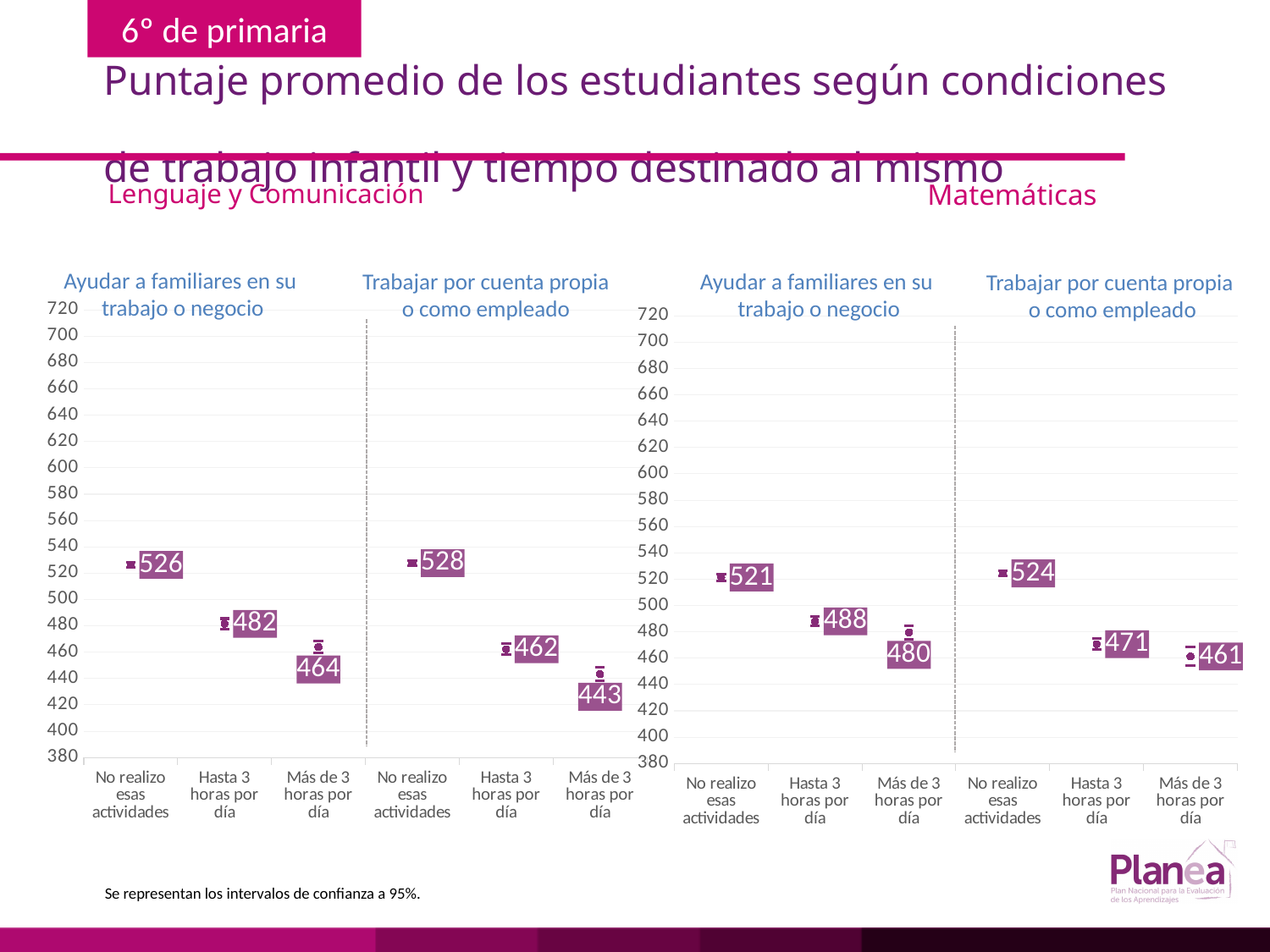
In the Matemáticas chart, what is the difference between the scores for No realizo esas actividades and Más de 3 horas por día within the Trabajar por cuenta propia group? 63 In the Lenguaje y Comunicación chart, what is the average score for students who work on their own or as employees more than 3 hours per day (Más de 3 horas por día, Trabajar por cuenta propia)? 443 In the Lenguaje y Comunicación chart, do the scores rise or fall as the hours of helping family per day increase? fall In the Lenguaje y Comunicación chart, what is the difference between the scores for No realizo esas actividades and Más de 3 horas por día within the Ayudar a familiares group? 62 In the Lenguaje y Comunicación chart, which category has the lowest average score? Más de 3 horas por día (Trabajar por cuenta propia o como empleado) In the Matemáticas chart, what is the average score for students who help family in their work or business up to 3 hours per day (Hasta 3 horas por día, Ayudar a familiares)? 488 In the Matemáticas chart, what is the average score for students who work on their own or as employees up to 3 hours per day (Hasta 3 horas por día, Trabajar por cuenta propia)? 471 What do the error bars around each point in the charts represent? Intervalos de confianza a 95% In the Matemáticas chart, which category has the highest average score? No realizo esas actividades (Trabajar por cuenta propia o como empleado) Which is higher: the Lenguaje y Comunicación score for Más de 3 horas por día in the Ayudar a familiares group, or the Matemáticas score for the same category? Matemáticas (480) In the Lenguaje y Comunicación chart, what is the average score for students who do not help family in their work or business (No realizo esas actividades, Ayudar a familiares)? 526 How many data points are plotted in the Matemáticas chart? 6